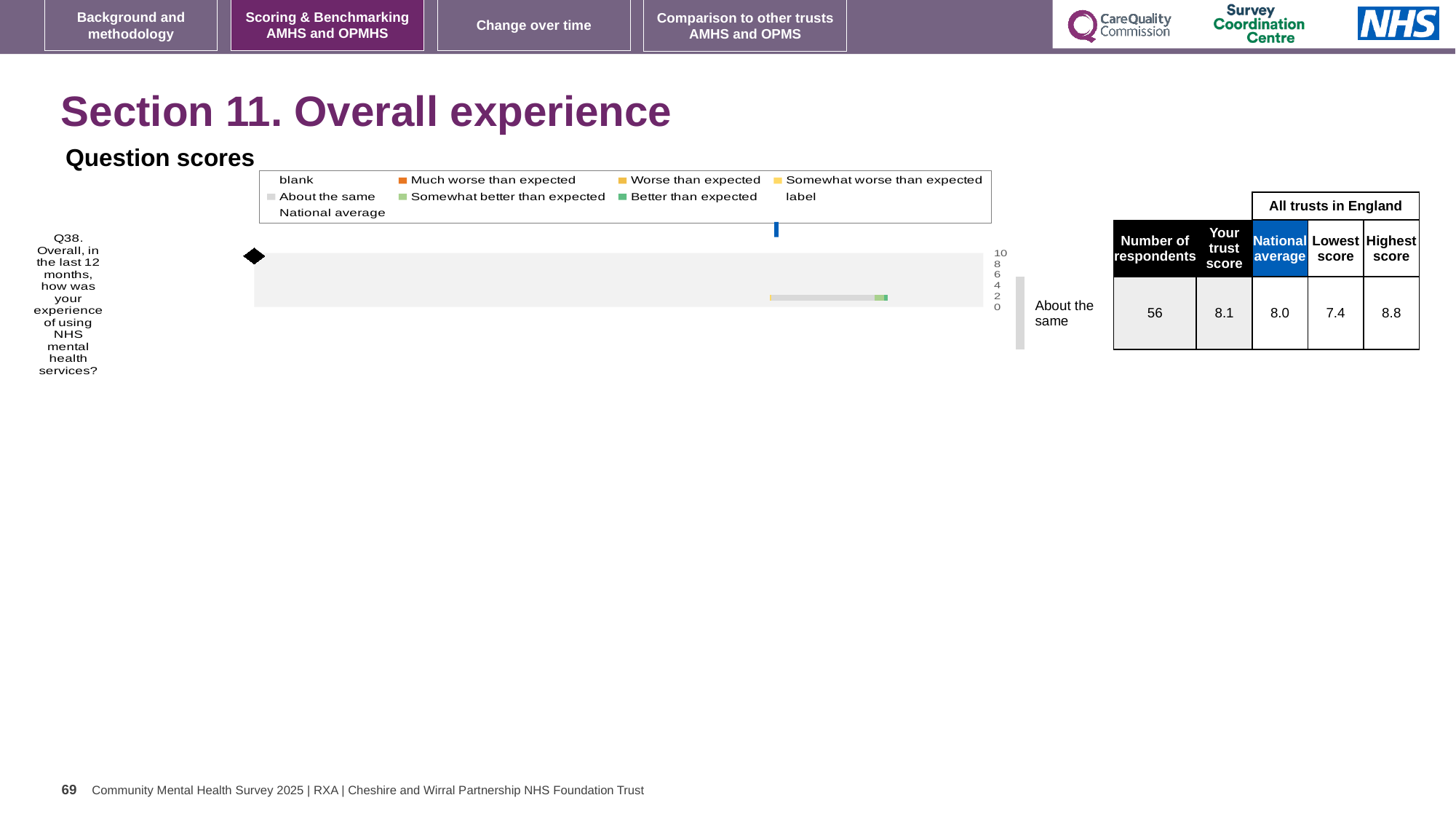
What benchmark category is shown next to the chart for Q38? About the same In the table beside the chart, what is the difference between the highest and lowest scores for Q38? 1.4 In the table beside the chart, what is the highest score among all trusts in England for Q38? 8.8 In the table beside the chart, what is the national average for Q38? 8.0 Which question is plotted on the chart? Q38. Overall, in the last 12 months, how was your experience of using NHS mental health services? What is the highest tick value shown on the chart's axis? 10 What kind of chart is shown under 'Question scores'? bar chart In the table beside the chart, what is the lowest score among all trusts in England for Q38? 7.4 How many question categories are plotted on the chart? 1 In the table beside the chart, which is larger for Q38: the trust score or the national average? the trust score In the table beside the chart, what is the number of respondents for Q38? 56 In the table beside the chart, what is the trust score for Q38? 8.1